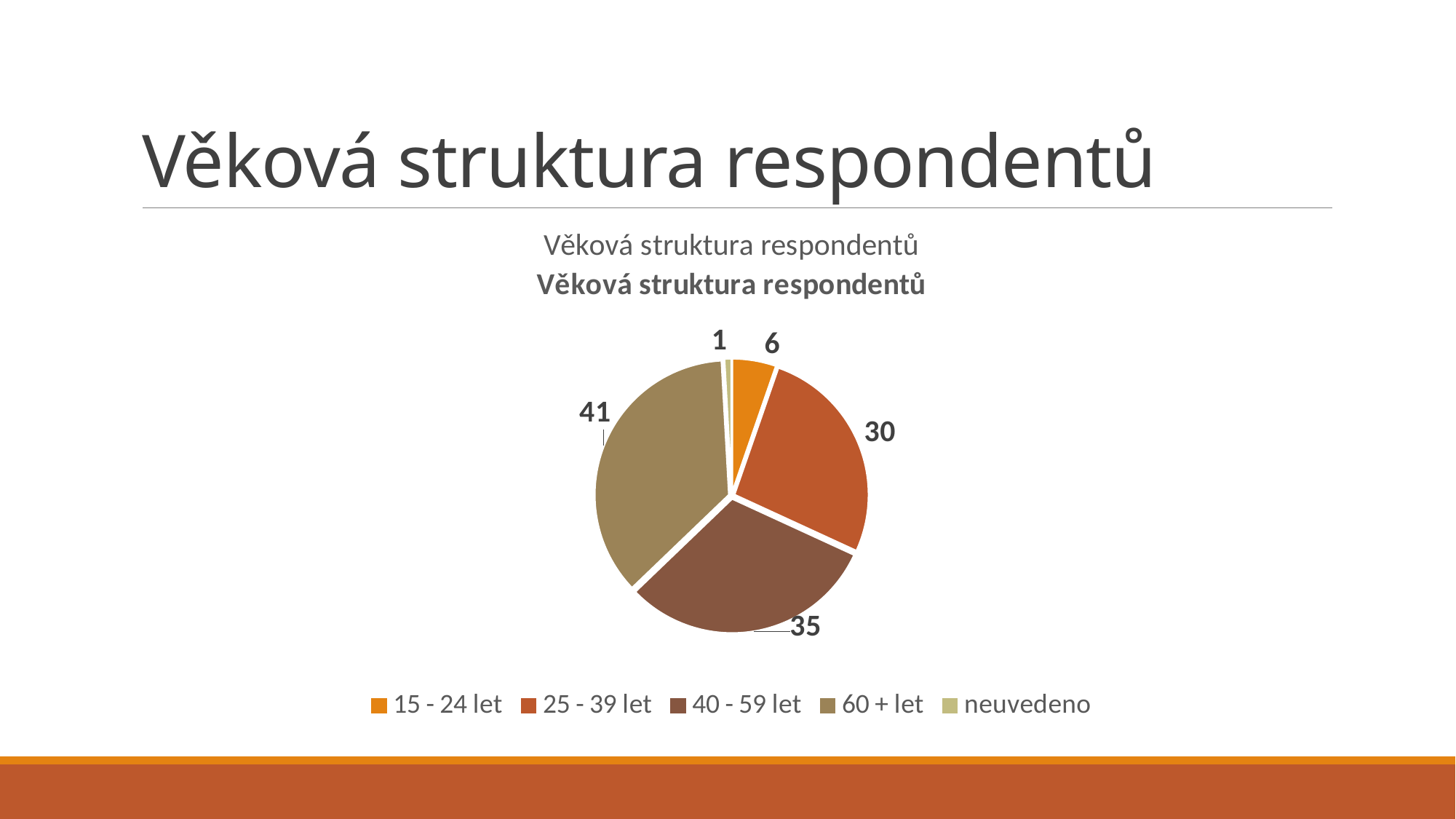
How many categories does the legend list? 5 Which age category has the largest slice? 60 + let What is the value for the neuvedeno slice? 1 What is the difference between the 60 + let and 40 - 59 let values? 6 What is the value for the 40 - 59 let slice? 35 Which category has the smallest slice? neuvedeno What type of chart is shown on the slide? pie chart What is the title of the chart? Věková struktura respondentů Which is larger, the 25 - 39 let slice or the 40 - 59 let slice? 40 - 59 let What is the value for the 25 - 39 let slice? 30 What is the value for the 60 + let slice? 41 What is the value for the 15 - 24 let slice? 6